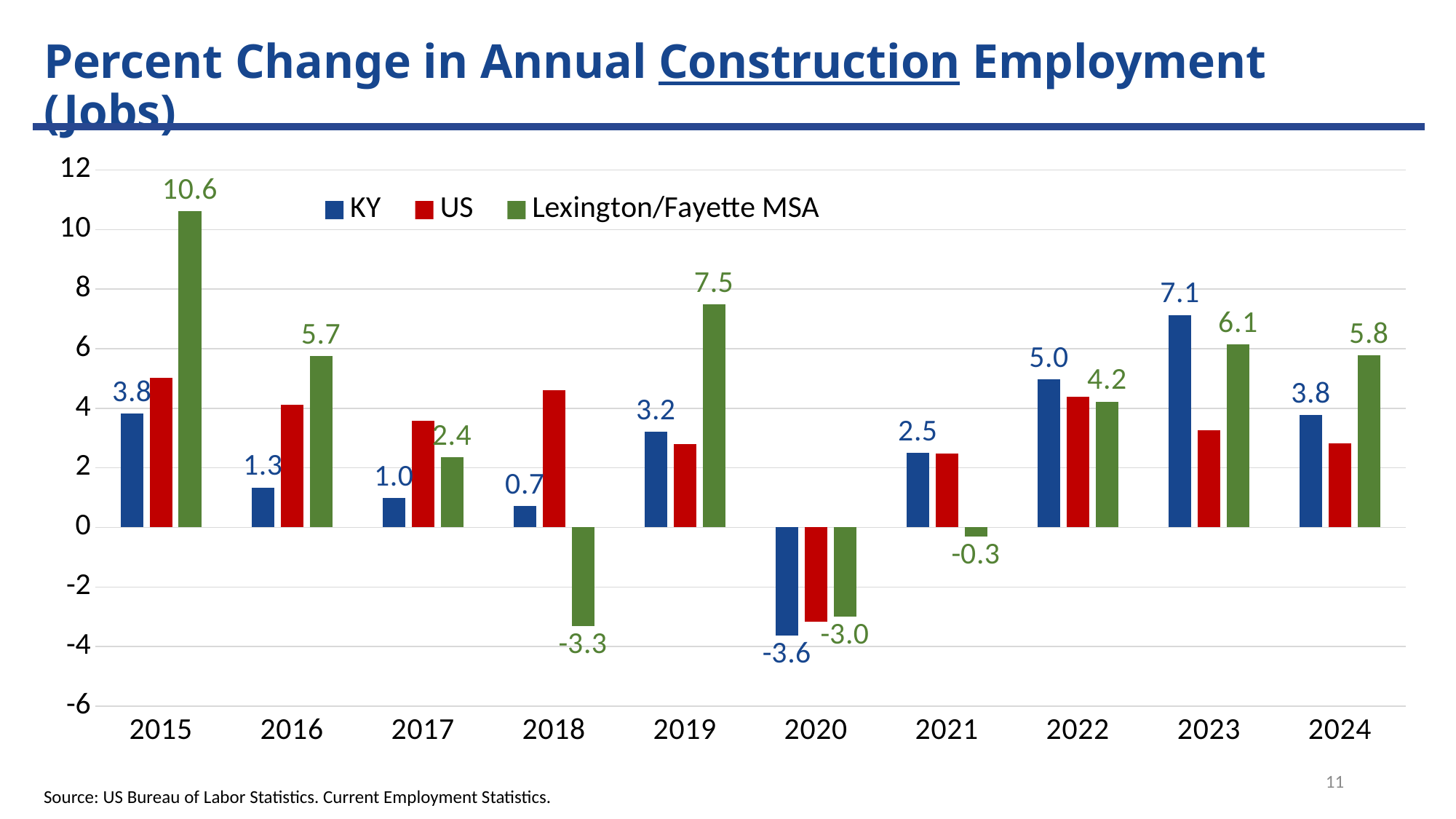
Which is larger in 2024, the KY value or the Lexington/Fayette MSA value? Lexington/Fayette MSA What is the difference between the Lexington/Fayette MSA value and the KY value in 2019? 4.3 How many years are shown on the x axis? 10 What kind of chart is shown on the slide? bar chart Is the value for US in 2018 greater or less than 4? greater What is the value for KY in 2023? 7.1 What is the value for Lexington/Fayette MSA in 2021? -0.3 How many series does the legend list? 3 In which year is the Lexington/Fayette MSA value lowest? 2018 What is the value for Lexington/Fayette MSA in 2015? 10.6 Does the KY value rise or fall from 2021 to 2023? rise In which year is the KY value highest? 2023